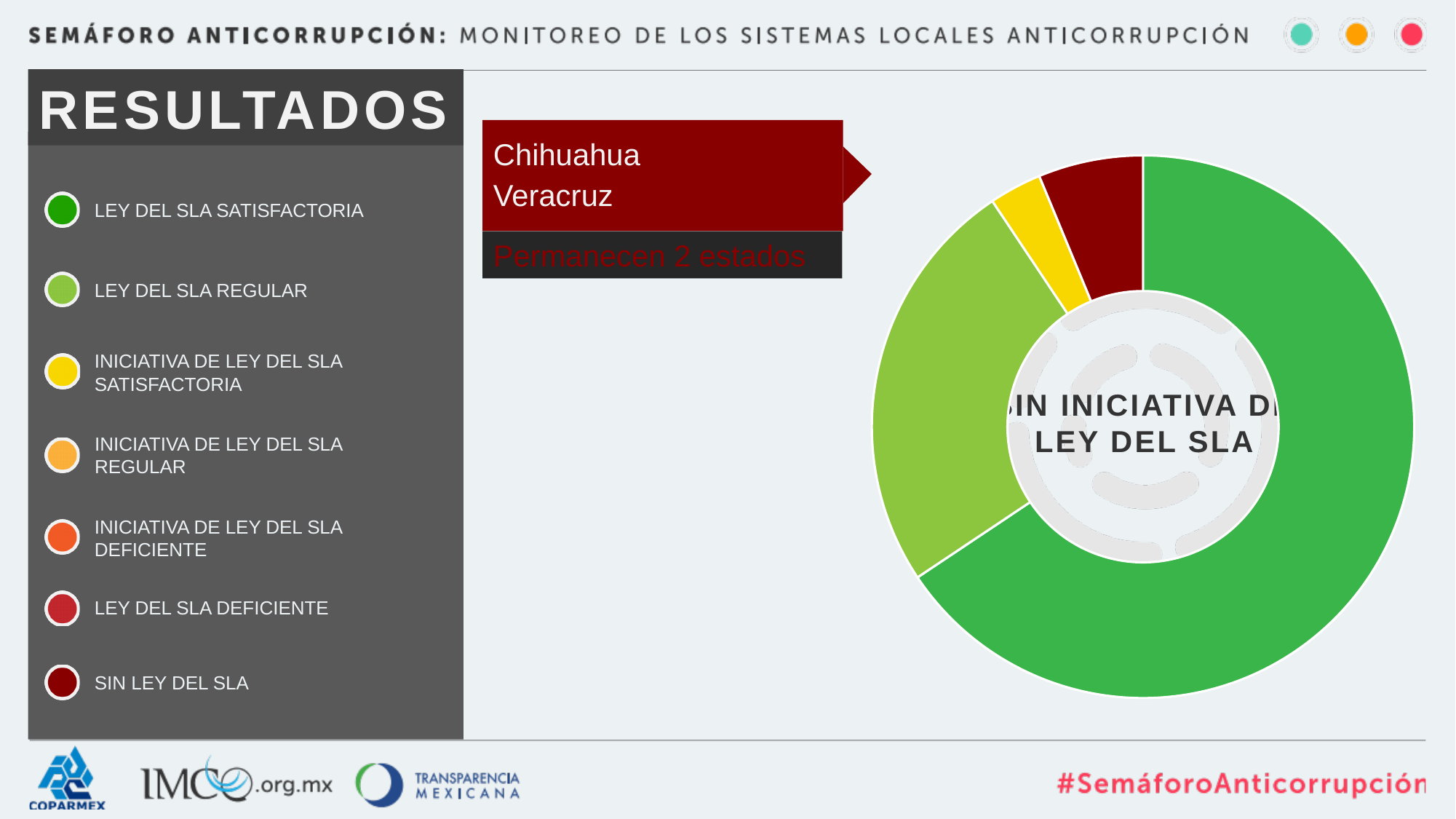
Which is larger in the donut chart: the LEY DEL SLA SATISFACTORIA slice or the LEY DEL SLA REGULAR slice? LEY DEL SLA SATISFACTORIA Which category has the largest slice in the donut chart? LEY DEL SLA SATISFACTORIA What kind of chart is shown on the slide? Donut (pie) chart Which is larger in the donut chart: the SIN LEY DEL SLA slice or the INICIATIVA DE LEY DEL SLA SATISFACTORIA slice? SIN LEY DEL SLA How many categories does the legend on the left list? 7 Is the LEY DEL SLA SATISFACTORIA slice more or less than half of the donut chart? more What colour represents SIN LEY DEL SLA in the legend? Dark red Which two states are named in the red callout box? Chihuahua and Veracruz According to the callout, how many states remain ("Permanecen") in the highlighted category? 2 estados How many slices are visible in the donut chart? 4